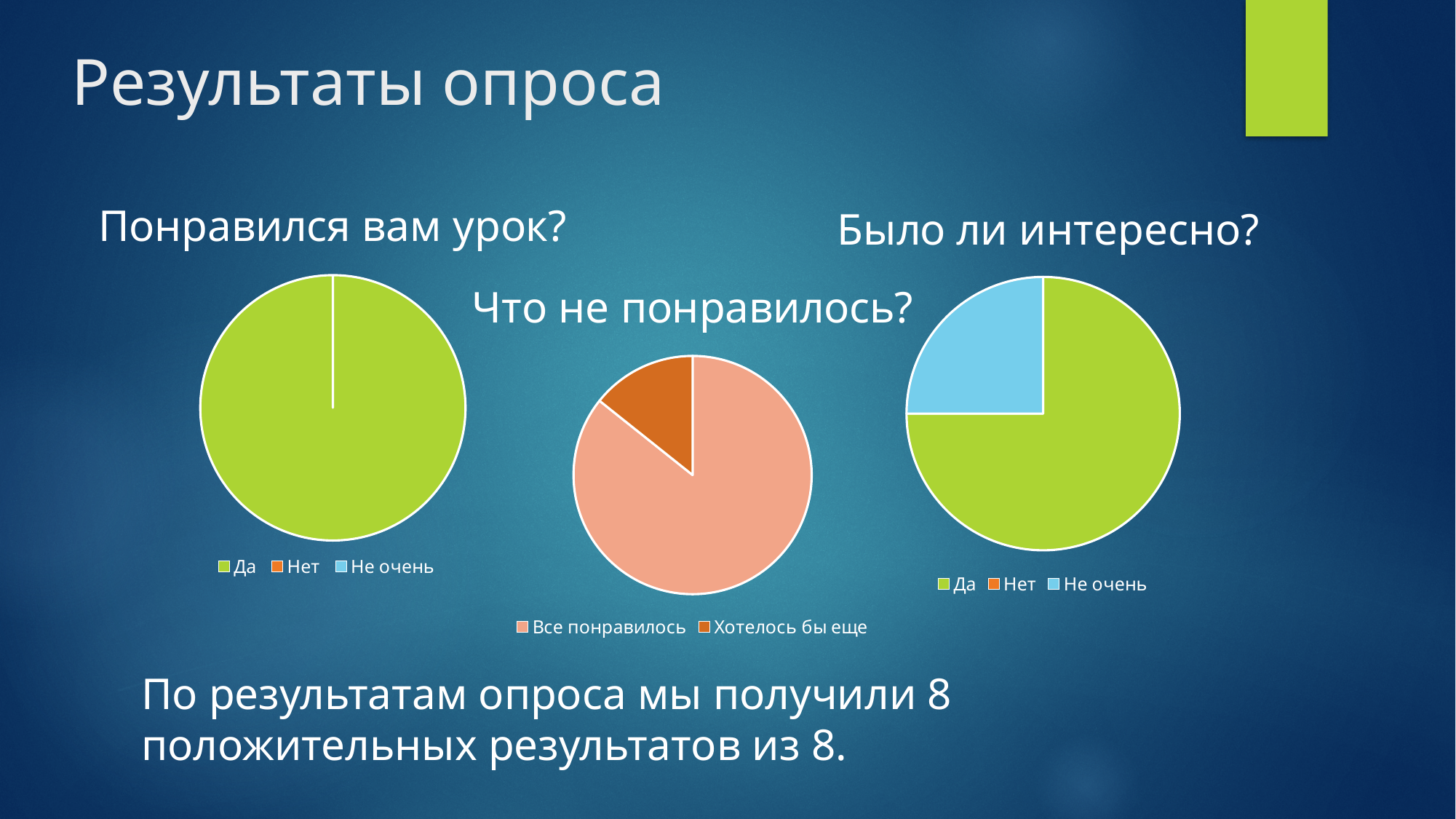
What type of chart is used for "Понравился вам урок?"? Pie chart In the "Было ли интересно?" chart, which category has the largest slice? Да In the "Было ли интересно?" chart, what colour is the "Не очень" slice? Light blue How many entries does the legend of the "Было ли интересно?" chart list? 3 In the "Что не понравилось?" chart, which slice is larger: "Все понравилось" or "Хотелось бы еще"? Все понравилось In the "Было ли интересно?" chart, which slice is larger: "Да" or "Не очень"? Да In the "Что не понравилось?" chart, which category has the largest slice? Все понравилось How many entries does the legend of the "Понравился вам урок?" chart list? 3 How many pie charts are shown on the slide? 3 How many entries does the legend of the "Что не понравилось?" chart list? 2 In the "Что не понравилось?" chart, which category has the smallest slice? Хотелось бы еще In the "Понравился вам урок?" chart, which category takes up the whole pie? Да